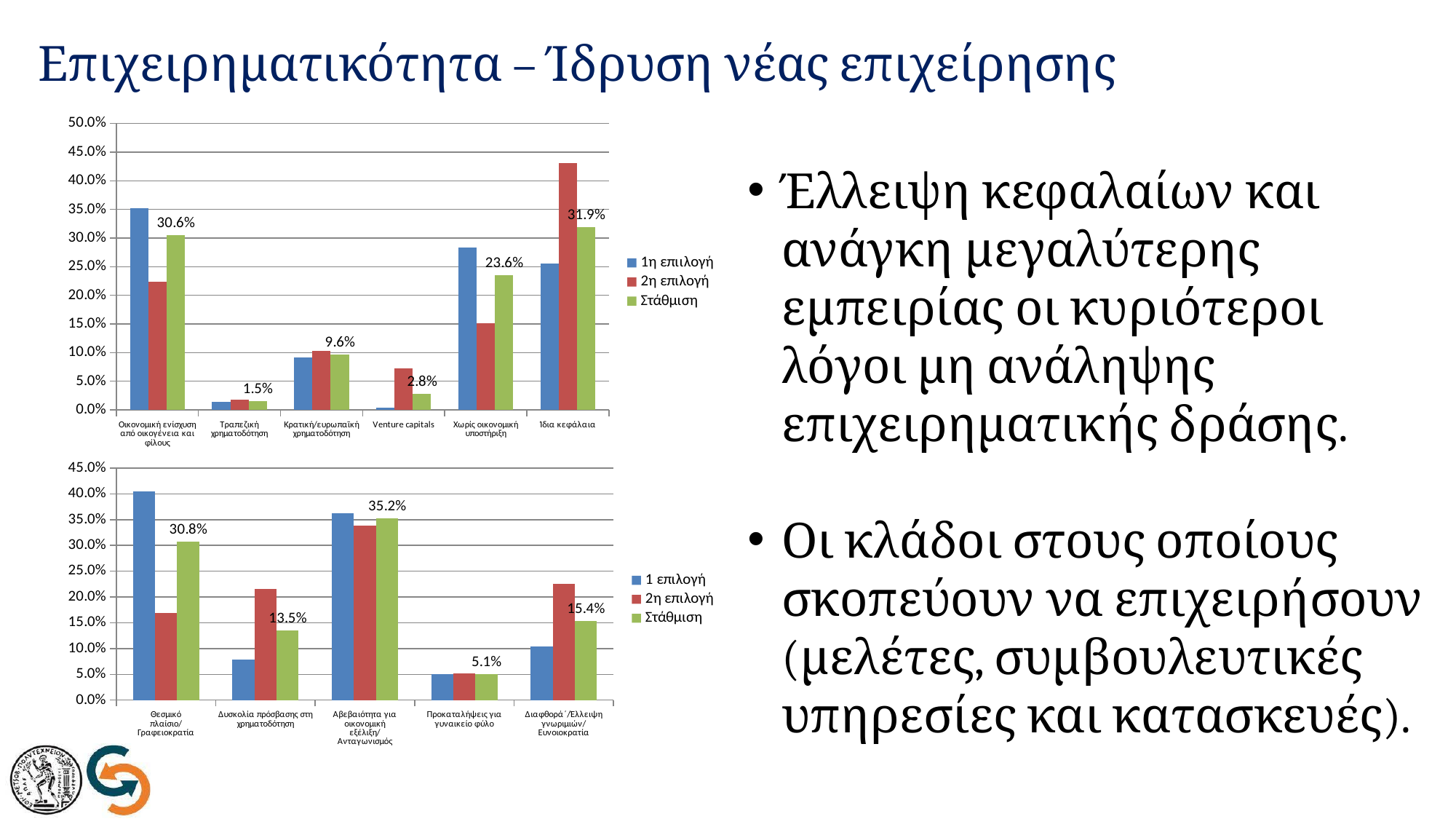
In the bottom chart, which category has the highest Στάθμιση value? Αβεβαιότητα για οικονομική εξέλιξη/Ανταγωνισμός In the bottom chart, what is the Στάθμιση value for Αβεβαιότητα για οικονομική εξέλιξη/Ανταγωνισμός? 35.2% In the top chart, what is the difference between the Στάθμιση values for Ίδια κεφάλαια and Χωρίς οικονομική υποστήριξη? 8.3% How many series does the legend of the bottom chart list? 3 In the top chart, which category has the lowest Στάθμιση value? Τραπεζική χρηματοδότηση In the top chart, what is the Στάθμιση value for Venture capitals? 2.8% In the top chart, what is the Στάθμιση value for Ίδια κεφάλαια? 31.9% In the bottom chart, is the 1 επιλογή value for Θεσμικό πλαίσιο/Γραφειοκρατία greater or less than 35.0%? greater In the top chart, how many categories are shown on the x axis? 6 In the top chart, is the 2η επιλογή value for Ίδια κεφάλαια greater or less than 40.0%? greater What type of chart is the top chart? Bar chart In the bottom chart, which is larger: the Στάθμιση value for Δυσκολία πρόσβασης στη χρηματοδότηση or for Διαφθορά/Έλλειψη γνωριμιών/Ευνοιοκρατία? Διαφθορά/Έλλειψη γνωριμιών/Ευνοιοκρατία